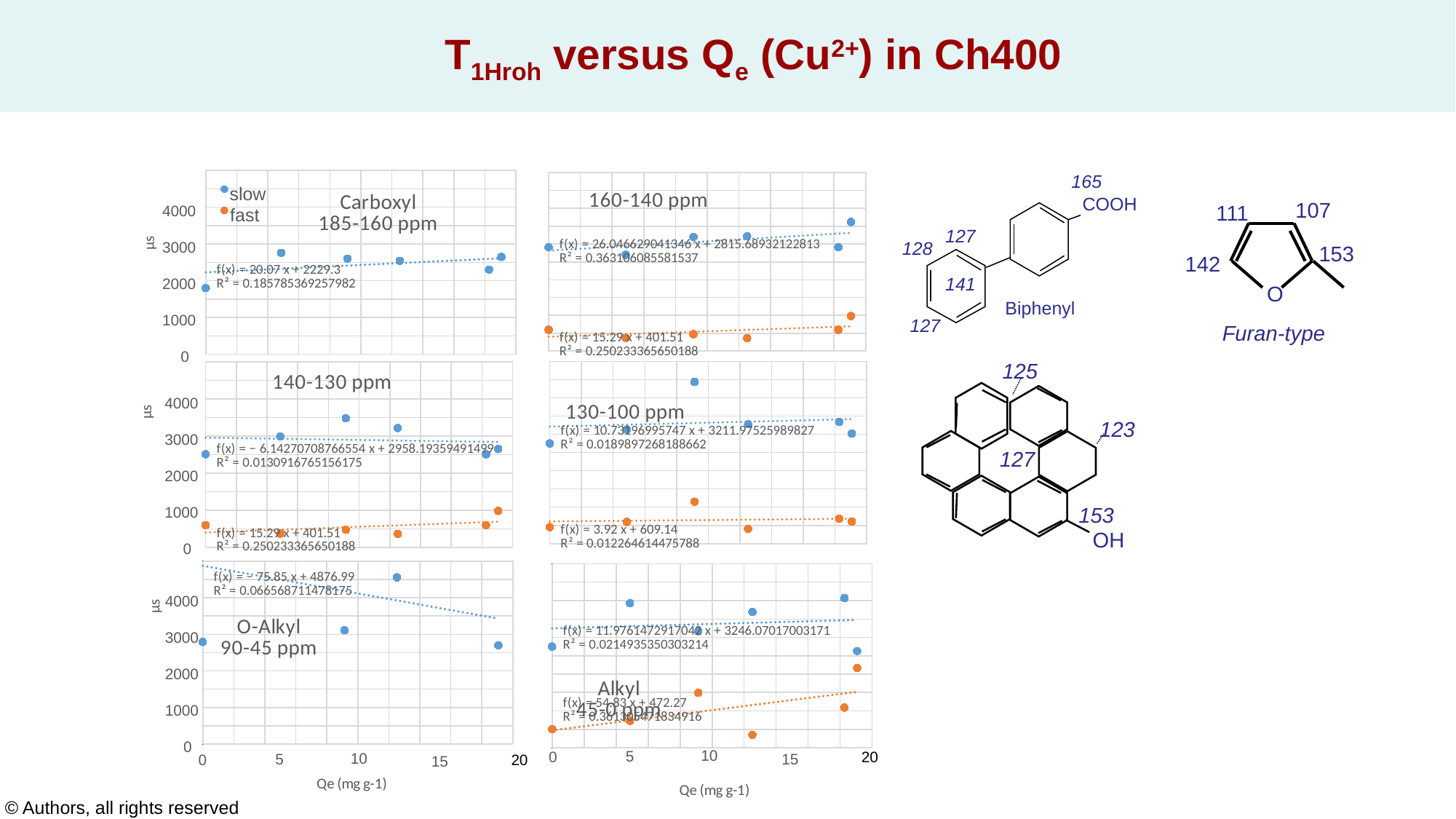
In the Carboxyl 185-160 ppm chart, does the slow-series trendline rise or fall as Qe increases? rise In the 140-130 ppm chart, which series has the larger values, slow or fast? slow In the Carboxyl 185-160 ppm chart, is the slow-series value at Qe = 0 greater or less than 3000? less How many series does the legend in the Carboxyl 185-160 ppm chart list? 2 How many chart panels are shown on the slide? 6 In the 140-130 ppm chart, is the fast-series value at the highest Qe greater or less than 2000? less What are the two legend entries shown in the Carboxyl 185-160 ppm chart? slow and fast What is the x-axis label of the charts? Qe (mg g-1) What kind of chart is used in the panels on this slide? scatter chart In the O-Alkyl 90-45 ppm chart, is the slow-series value near Qe = 12 greater or less than 4000? greater In the O-Alkyl 90-45 ppm chart, does the slow-series trendline rise or fall as Qe increases? fall